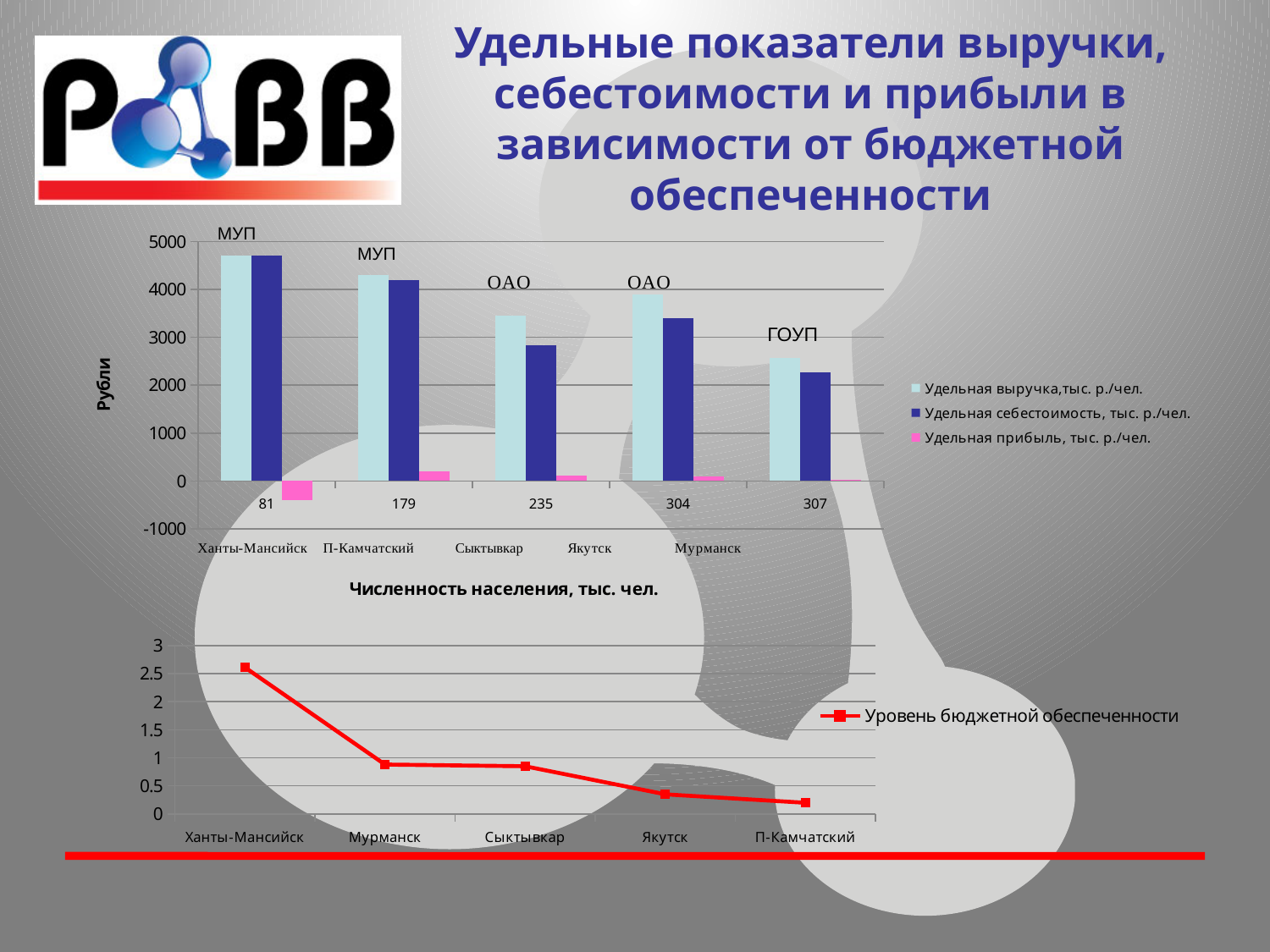
How many categories are shown on the x axis of the top chart? 5 In the top chart, is the value of Удельная выручка for category 235 greater or less than 3000? greater In the bottom chart, is the value for Ханты-Мансийск greater or less than 2? greater How many series does the legend of the top chart list? 3 In the top chart, which is larger: Удельная выручка for category 304 or for category 235? 304 What kind of chart is the bottom chart on the slide? line chart In the bottom chart, which city has the highest Уровень бюджетной обеспеченности? Ханты-Мансийск In the top chart, which category has the highest value for Удельная выручка, тыс. р./чел.? 81 In the bottom chart, do the values rise or fall from left to right along the x axis? fall In the top chart, is the value of Удельная прибыль for category 81 greater or less than 0? less What kind of chart is the top chart on the slide? bar chart In the top chart, which category has the lowest value for Удельная себестоимость, тыс. р./чел.? 307